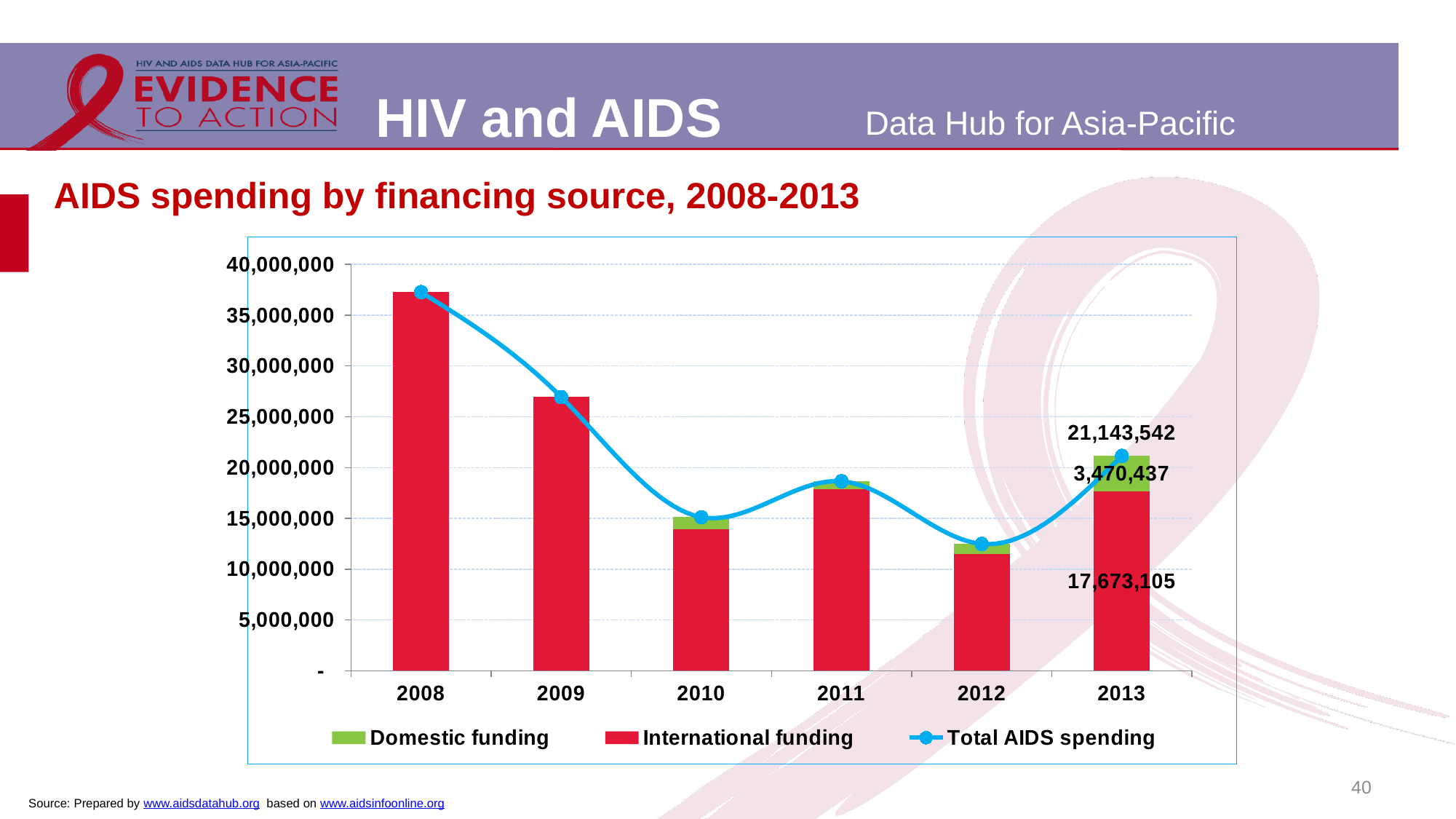
Is the Total AIDS spending for 2012 greater or less than 15,000,000? less Which year has the highest Total AIDS spending? 2008 What is the Total AIDS spending value labelled for 2013? 21,143,542 How many years are shown on the x axis? 6 Is the Total AIDS spending for 2008 greater or less than 35,000,000? greater What kind of chart is used to show Domestic funding and International funding? Stacked bar chart What is the Domestic funding value labelled for 2013? 3,470,437 How many series does the legend list? 3 Which year has higher Total AIDS spending, 2009 or 2011? 2009 What is the International funding value labelled for 2013? 17,673,105 Which year has the lowest Total AIDS spending? 2012 In 2013, how much larger is International funding than Domestic funding? 14,202,668